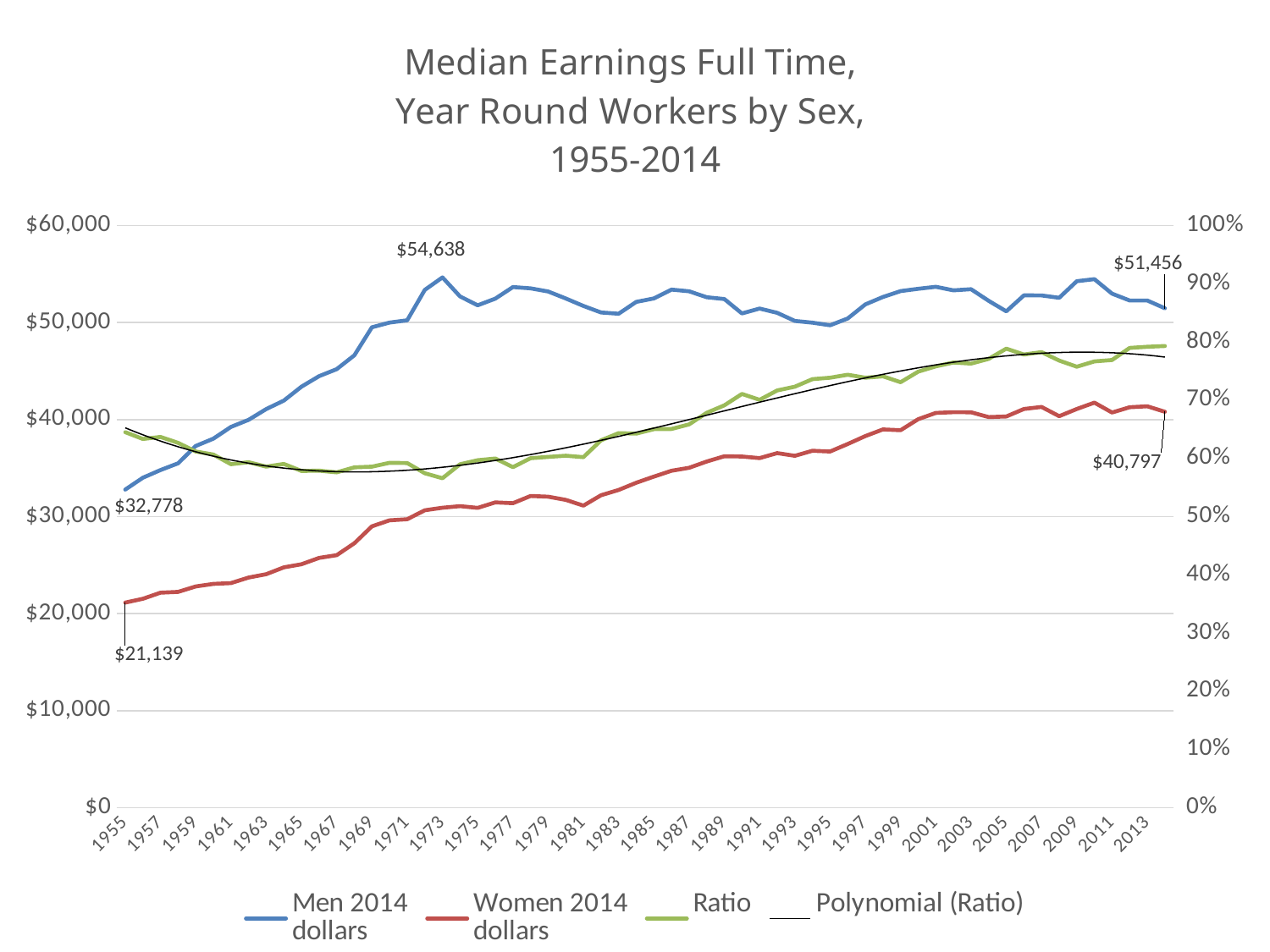
Is the value for Women 2014 dollars in 1981 greater or less than $40,000? less What is the difference between the labeled 2014 values for men ($51,456) and women ($40,797)? $10,659 What is the labeled value for Women 2014 dollars in 1955? $21,139 What is the labeled value for Men 2014 dollars at the end of the series in 2014? $51,456 What is the labeled value for Men 2014 dollars at the start of the series in 1955? $32,778 Which series has the higher labeled value in 2014, Men 2014 dollars or Women 2014 dollars? Men 2014 dollars What kind of chart is shown on the slide? Line chart What is the labeled peak value of the Men 2014 dollars line in the early 1970s? $54,638 How many series does the legend list? 4 What is the difference between the labeled 1955 values for men ($32,778) and women ($21,139)? $11,639 Is the Ratio value in 2013 greater or less than 70%? greater What is the labeled value for Women 2014 dollars at the end of the series in 2014? $40,797